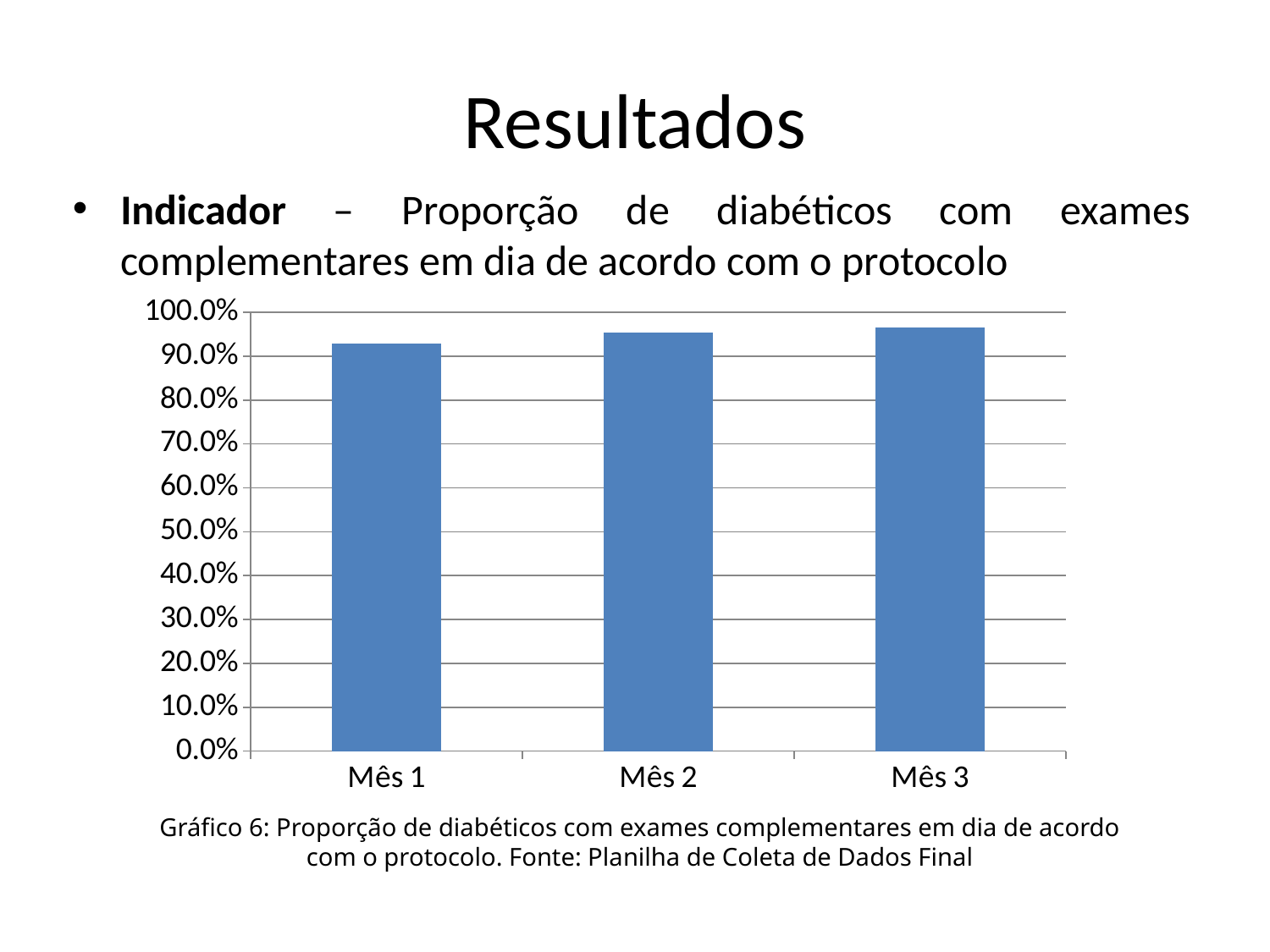
How many categories (months) are plotted on the x axis? 3 Which month has the lowest bar? Mês 1 Is the value for Mês 3 greater or less than 100.0%? less What kind of chart is shown on the slide? bar chart Is the value for Mês 1 greater or less than 80.0%? greater What is the highest tick value shown on the vertical axis? 100.0% What is the number of the graph given in the caption below the chart? Gráfico 6 Which is larger, the value for Mês 1 or the value for Mês 3? Mês 3 Is the value for Mês 1 greater or less than 90.0%? greater Do the values rise or fall from Mês 1 to Mês 3? rise